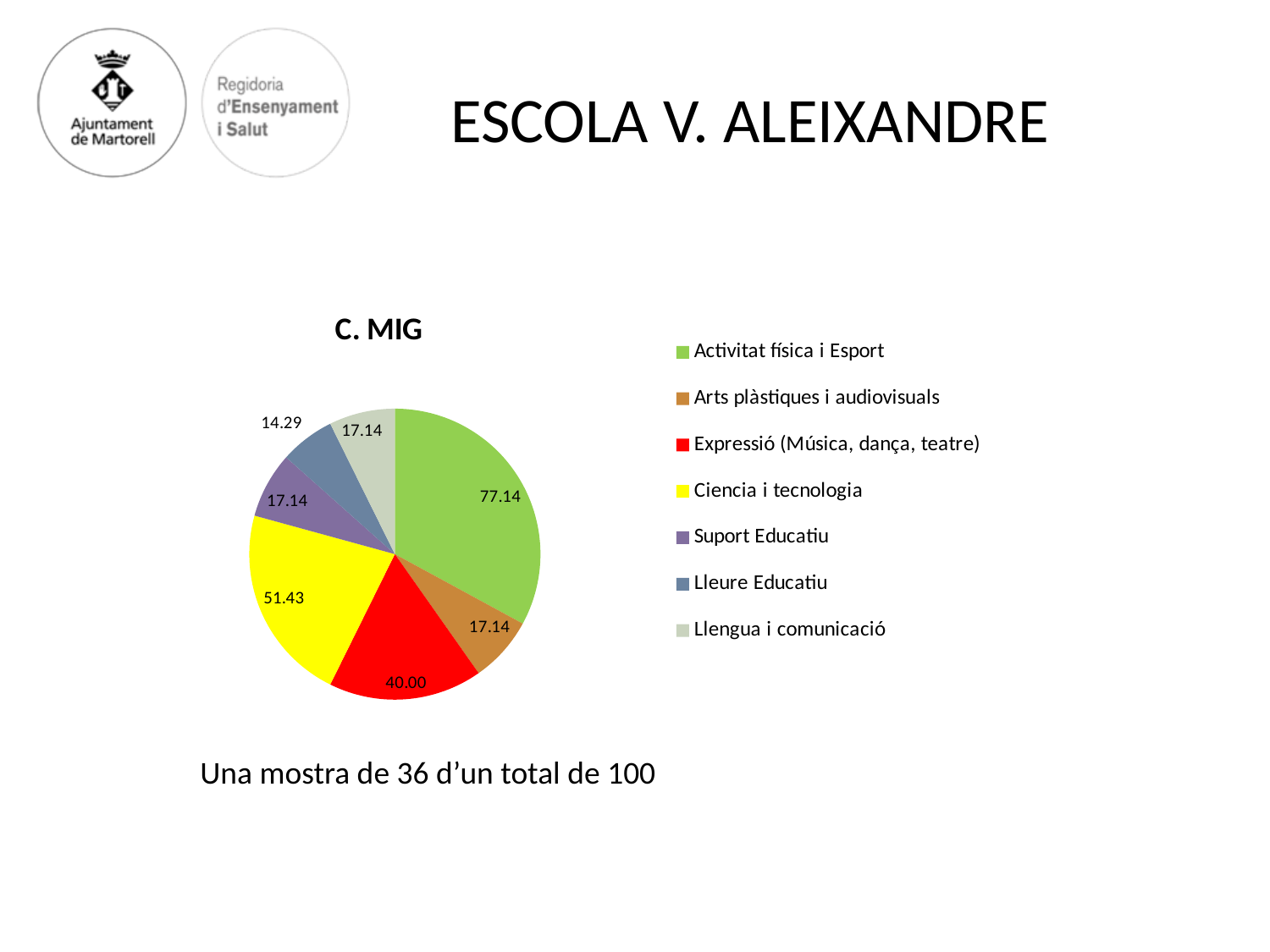
What is the value shown for Activitat física i Esport in the C. MIG pie chart? 77.14 What is the value shown for Ciencia i tecnologia in the C. MIG pie chart? 51.43 What is the difference between the values for Activitat física i Esport and Ciencia i tecnologia in the C. MIG pie chart? 25.71 Which is larger in the C. MIG pie chart, Expressió (Música, dança, teatre) or Ciencia i tecnologia? Ciencia i tecnologia What is the value shown for Expressió (Música, dança, teatre) in the C. MIG pie chart? 40.00 What colour is the slice for Ciencia i tecnologia in the C. MIG pie chart? Yellow Which category has the smallest slice in the C. MIG pie chart? Lleure Educatiu What is the value shown for Suport Educatiu in the C. MIG pie chart? 17.14 What is the value shown for Lleure Educatiu in the C. MIG pie chart? 14.29 Which category has the largest slice in the C. MIG pie chart? Activitat física i Esport What type of chart is shown on the slide? Pie chart How many categories does the C. MIG pie chart show? 7